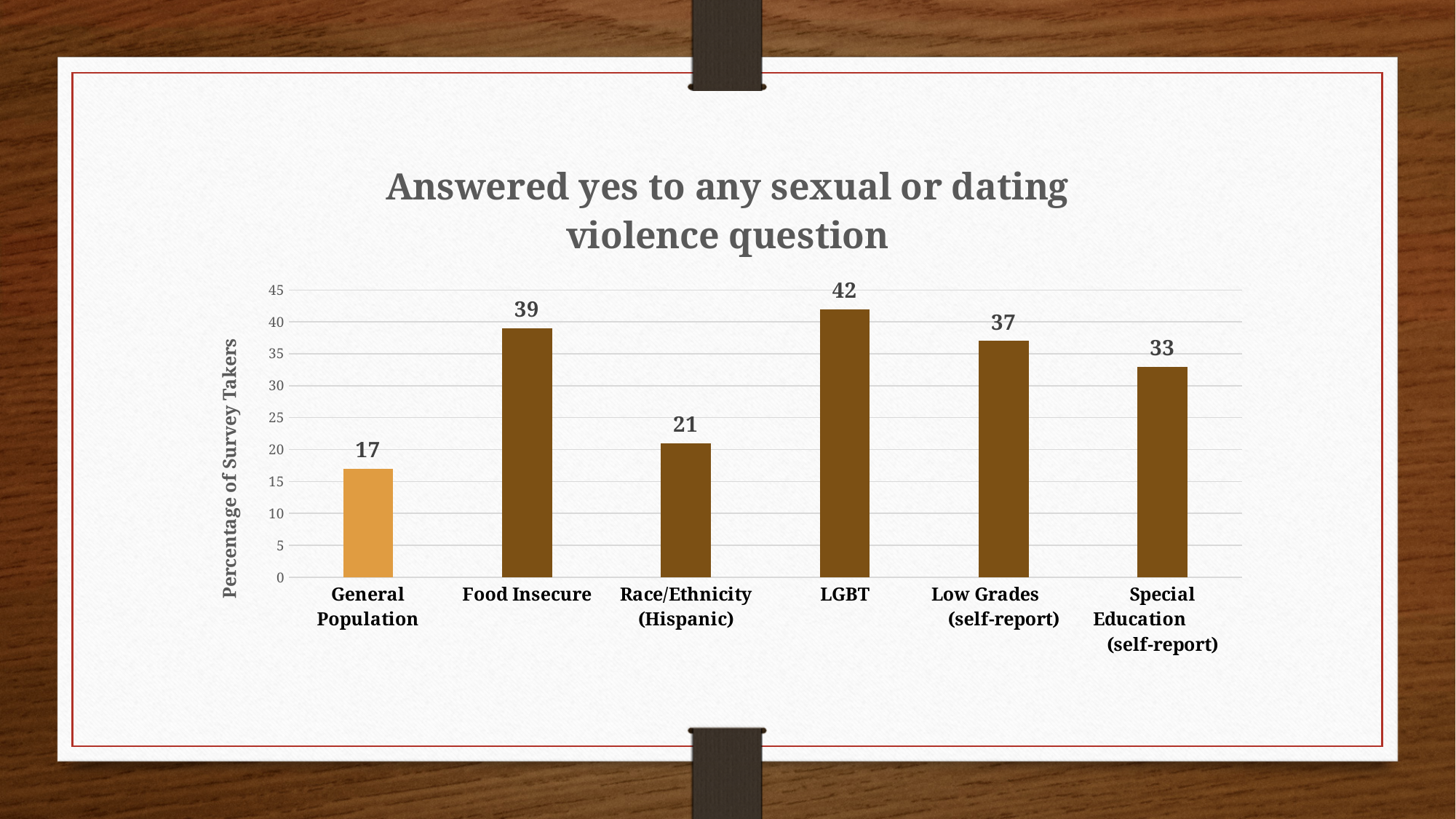
How many categories are shown on the x axis? 6 What is the difference between the values for Food Insecure and Low Grades (self-report)? 2 What is the difference between the values for LGBT and General Population? 25 What is the value for General Population? 17 What is the value for LGBT? 42 Which category has the lowest value? General Population What kind of chart is shown on the slide? bar chart What is the label of the vertical axis? Percentage of Survey Takers Which is larger, the value for Food Insecure or the value for Race/Ethnicity (Hispanic)? Food Insecure What is the value for Special Education (self-report)? 33 Which category has the highest value? LGBT Is the value for Low Grades (self-report) greater or less than 35? greater